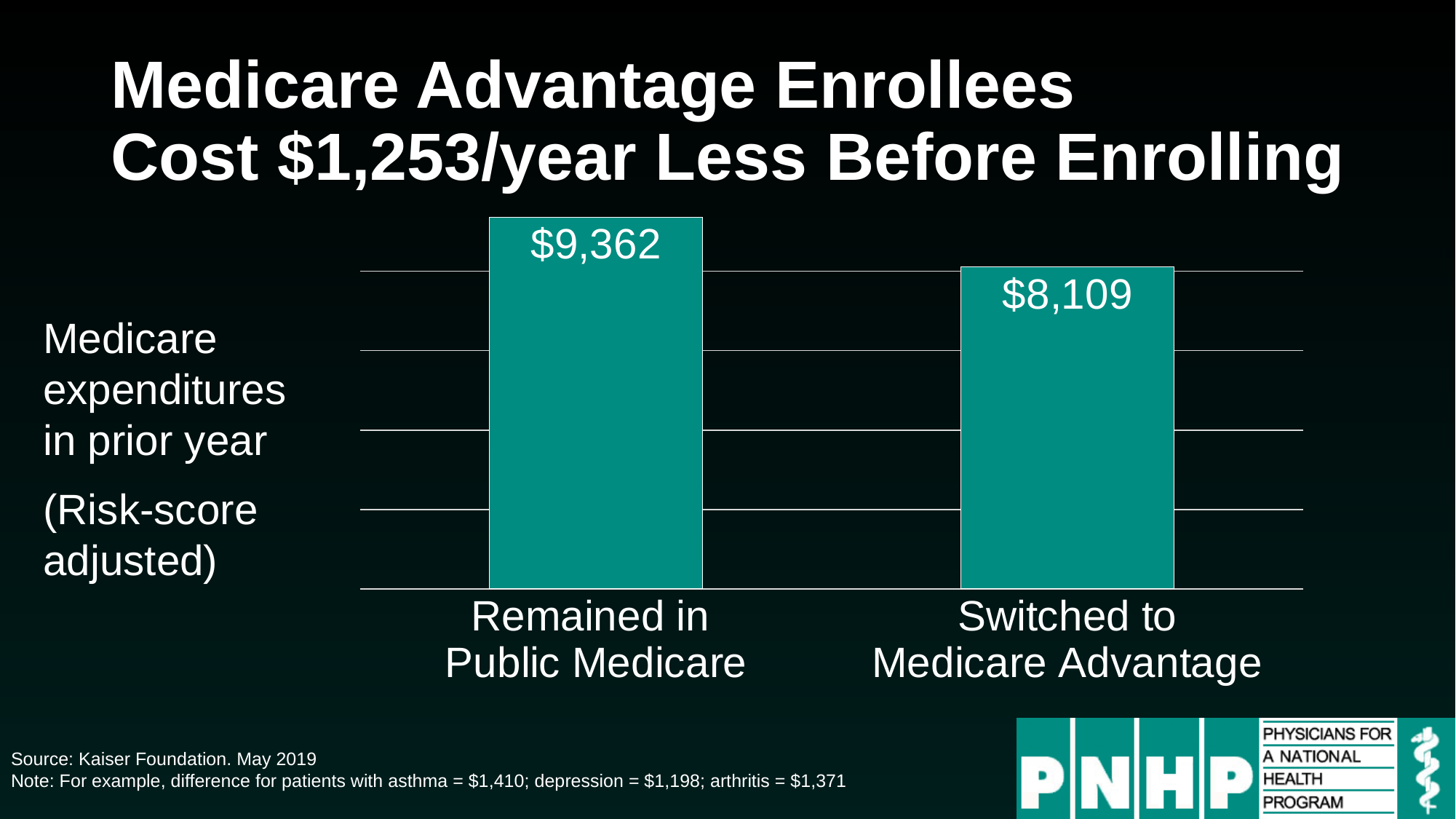
What is the source cited for the chart? Kaiser Foundation. May 2019 What is the difference in prior-year expenditures between those who remained in public Medicare and those who switched to Medicare Advantage? $1,253 What kind of chart is shown on the slide? Bar chart Which group had the higher prior-year Medicare expenditures? Remained in Public Medicare What were the prior-year Medicare expenditures for those who switched to Medicare Advantage? $8,109 How many groups are shown in the chart? 2 Were prior-year expenditures larger for those who remained in public Medicare or for those who switched to Medicare Advantage? Remained in Public Medicare What were the prior-year Medicare expenditures for those who remained in public Medicare? $9,362 Which group had the lower prior-year Medicare expenditures? Switched to Medicare Advantage What is the title of the slide? Medicare Advantage Enrollees Cost $1,253/year Less Before Enrolling